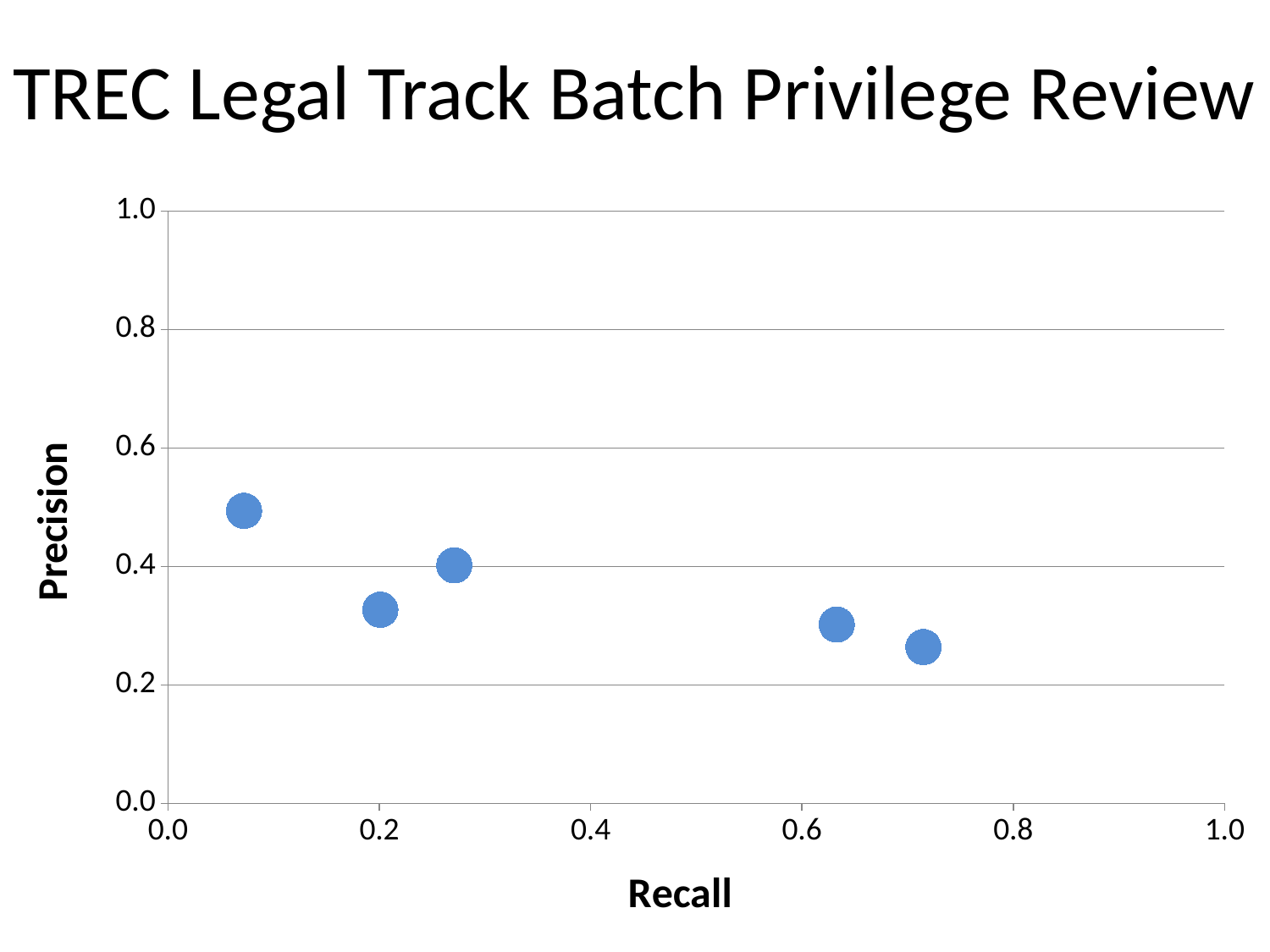
What is the label of the x axis? Recall How many points have a recall greater than 0.6? 2 What is the label of the y axis? Precision How many data points are plotted in the chart? 5 Overall, does precision rise or fall as recall increases along the x axis? fall Which point has the highest precision: the one with the lowest recall or the one with the highest recall? the one with the lowest recall Is the precision of the point with the lowest recall greater or less than 0.4? greater Is the recall of the leftmost point greater or less than 0.2? less Is the precision of the point with the highest recall greater or less than 0.4? less How many points have a recall less than 0.4? 3 What kind of chart is shown on the slide? scatter chart